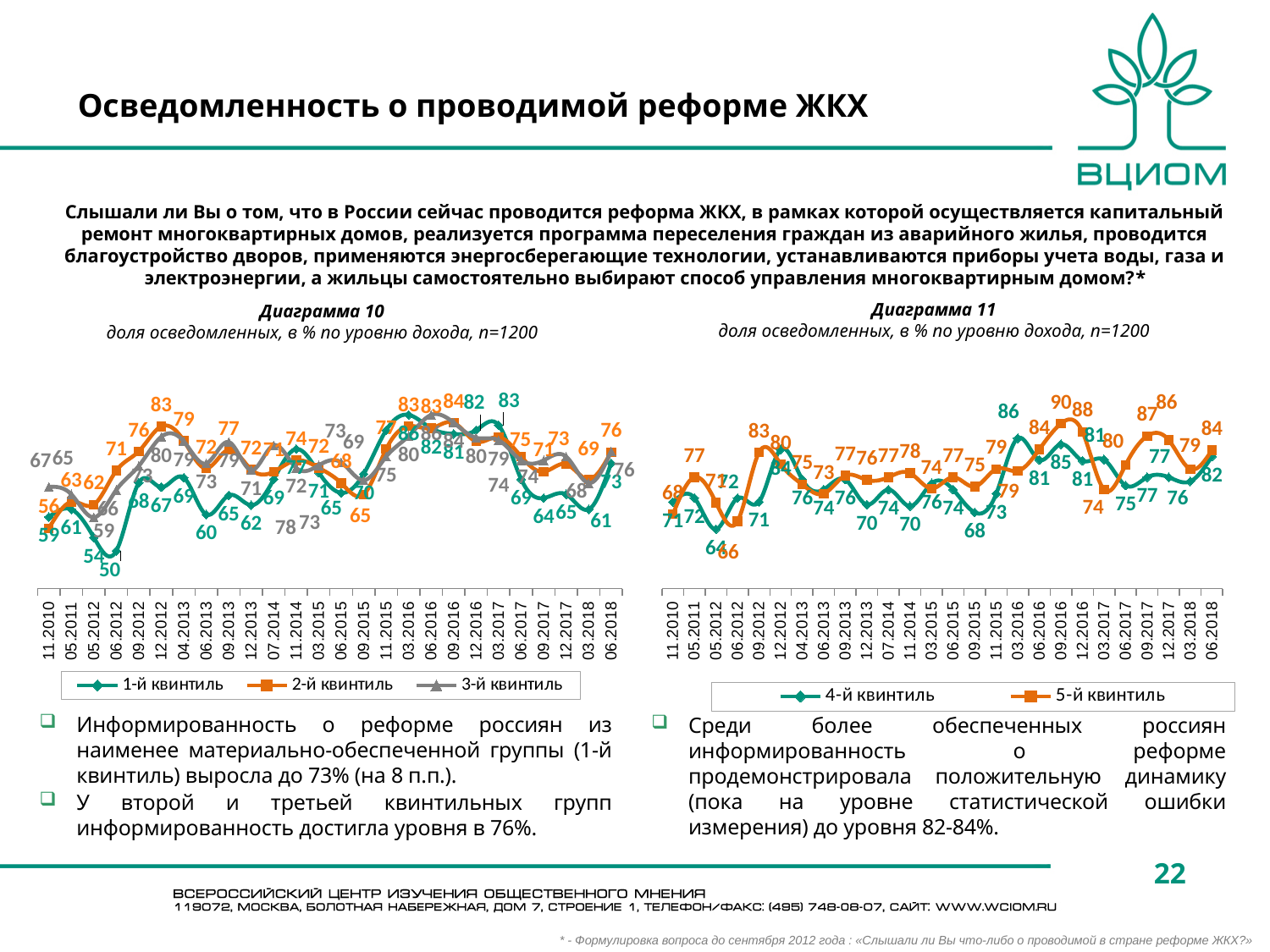
What type of chart is Диаграмма 10? line chart In Диаграмма 10, which series has the larger value at 06.2018: 1-й квинтиль or 2-й квинтиль? 2-й квинтиль In Диаграмма 11, what is the difference between the 5-й квинтиль and 4-й квинтиль values at 06.2018? 2 How many series does the legend of Диаграмма 11 list? 2 In Диаграмма 10, what is the lowest value reached by the 1-й квинтиль series? 50 In Диаграмма 11, does the 4-й квинтиль series rise or fall from 11.2010 to 06.2018? rise In Диаграмма 10, what is the value for the 1-й квинтиль series at 06.2018? 73 In Диаграмма 11, what is the value for the 5-й квинтиль series at 06.2018? 84 What are the legend entries of Диаграмма 11? 4-й квинтиль, 5-й квинтиль How many series does the legend of Диаграмма 10 list? 3 In Диаграмма 10, what is the value for the 2-й квинтиль series at 12.2012? 83 In Диаграмма 11, what is the highest value reached by the 5-й квинтиль series? 90